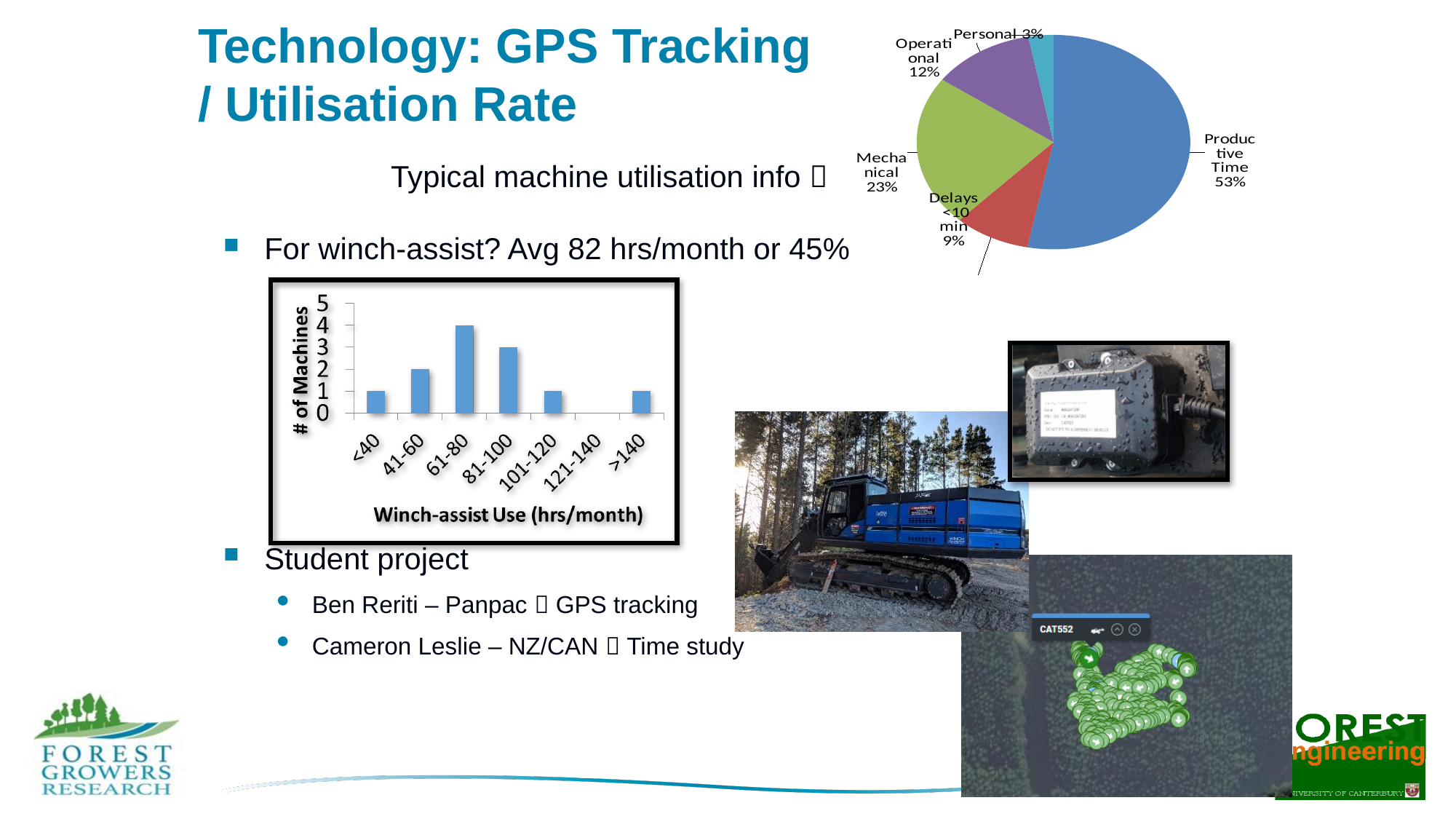
What type of chart is the one showing # of Machines by Winch-assist Use? Bar chart In the pie chart, what share is labelled Productive Time? 53% In the pie chart, which category has the smallest share? Personal In the bar chart of winch-assist use, how many machines are in the 81-100 hrs/month category? 3 In the bar chart of winch-assist use, how many machines are in the 61-80 hrs/month category? 4 In the pie chart, what percentage is shown for Mechanical? 23% In the pie chart, which category has the largest share? Productive Time In the bar chart of winch-assist use, which has more machines, 41-60 or 101-120? 41-60 In the pie chart, what is the difference between the Mechanical share and the Operational share? 11% In the bar chart of winch-assist use, how many categories are shown on the x axis? 7 In the bar chart of winch-assist use, which category has the most machines? 61-80 In the pie chart, how many slices are there? 5